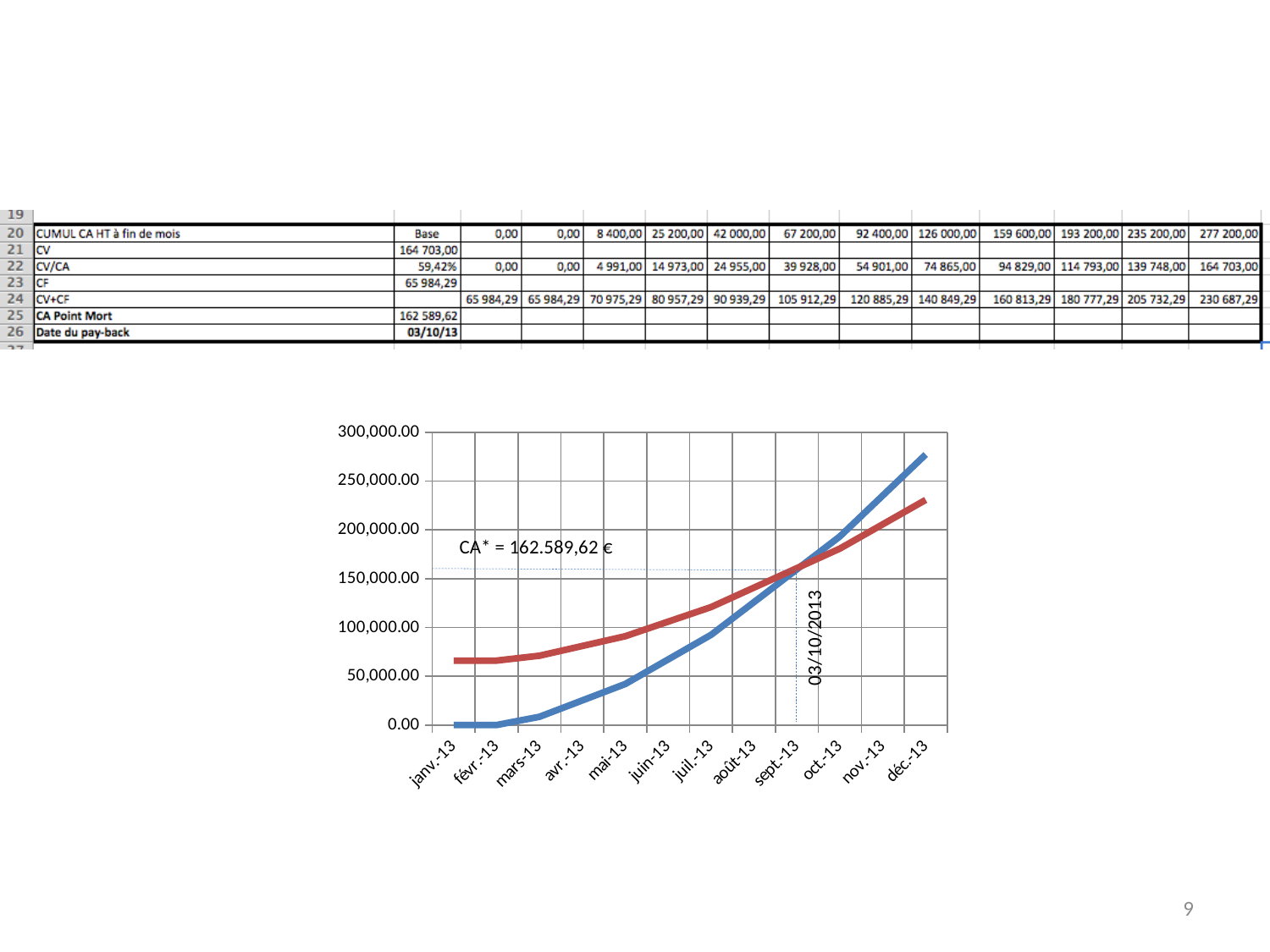
Does the blue line rise or fall from janv.-13 to déc.-13? rise Is the value of the blue line at déc.-13 greater or less than 250,000.00? greater At janv.-13, which line is higher, the blue line or the red line? the red line Is the value of the blue line at juin-13 greater or less than 100,000.00? less Is the value of the red line at janv.-13 greater or less than 50,000.00? greater How many months are shown along the x axis of the chart? 12 In which month does the blue line reach its highest value? déc.-13 What value is given in the CA* annotation on the chart? 162.589,62 € What date is written next to the vertical dotted line on the chart? 03/10/2013 At déc.-13, which line is higher, the blue line or the red line? the blue line What kind of chart is shown on the slide? line chart